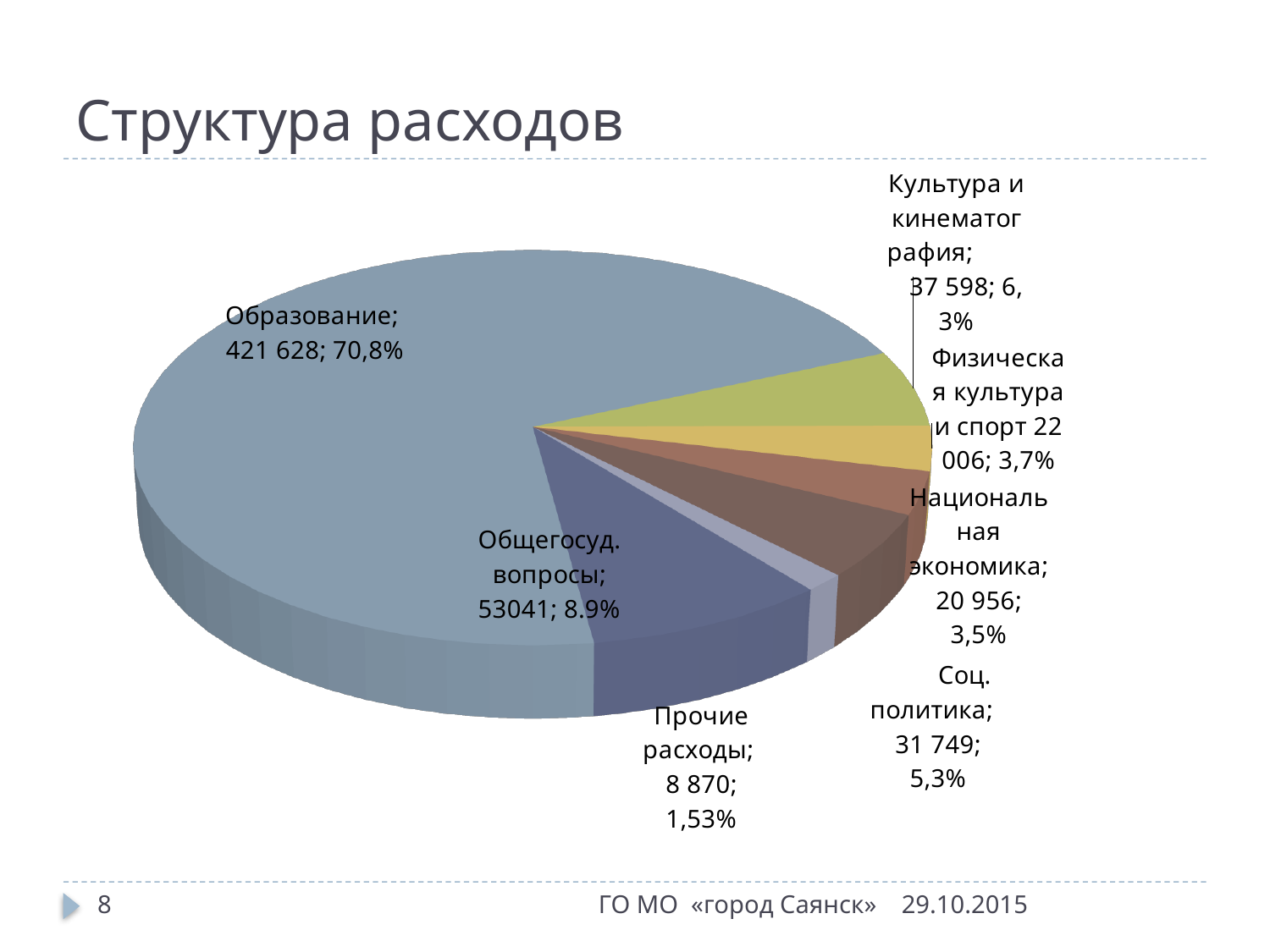
Which category has the smallest slice? Прочие расходы What share of the pie does Соц. политика take? 5,3% What value is shown for Национальная экономика? 20 956 Which is larger, Культура и кинематография or Физическая культура и спорт? Культура и кинематография Which category has the largest slice? Образование What is the difference between the values for Соц. политика and Прочие расходы? 22 879 What share of the pie does Образование take? 70,8% What value is shown for Общегосуд. вопросы? 53041 What kind of chart is shown on the slide? Pie chart What is the title of the chart? Структура расходов How many slices does the pie chart have? 7 What value is shown for Образование? 421 628